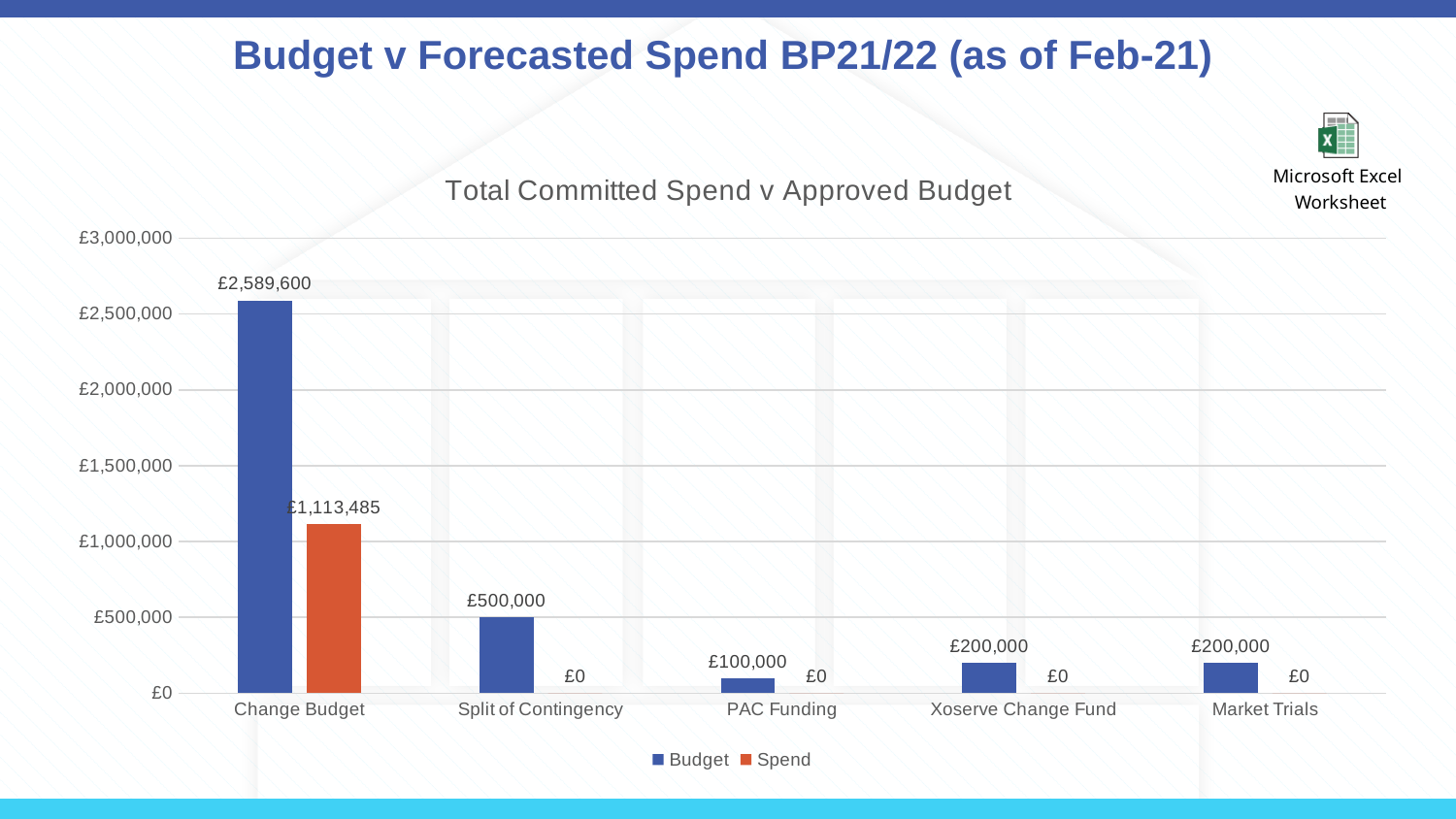
What type of chart is shown on the slide? Bar chart Which category has the lowest Budget value? PAC Funding Which category has the highest Budget value? Change Budget How many series does the legend list? 2 What is the Budget value for Split of Contingency? £500,000 What is the Spend value for Change Budget? £1,113,485 Which is larger, the Budget for Split of Contingency or the Budget for Xoserve Change Fund? Budget for Split of Contingency What is the Budget value for Change Budget? £2,589,600 What is the difference between the Budget and Spend values for Change Budget? £1,476,115 What is the Spend value for Market Trials? £0 How many categories are shown on the x axis? 5 What is the Budget value for PAC Funding? £100,000